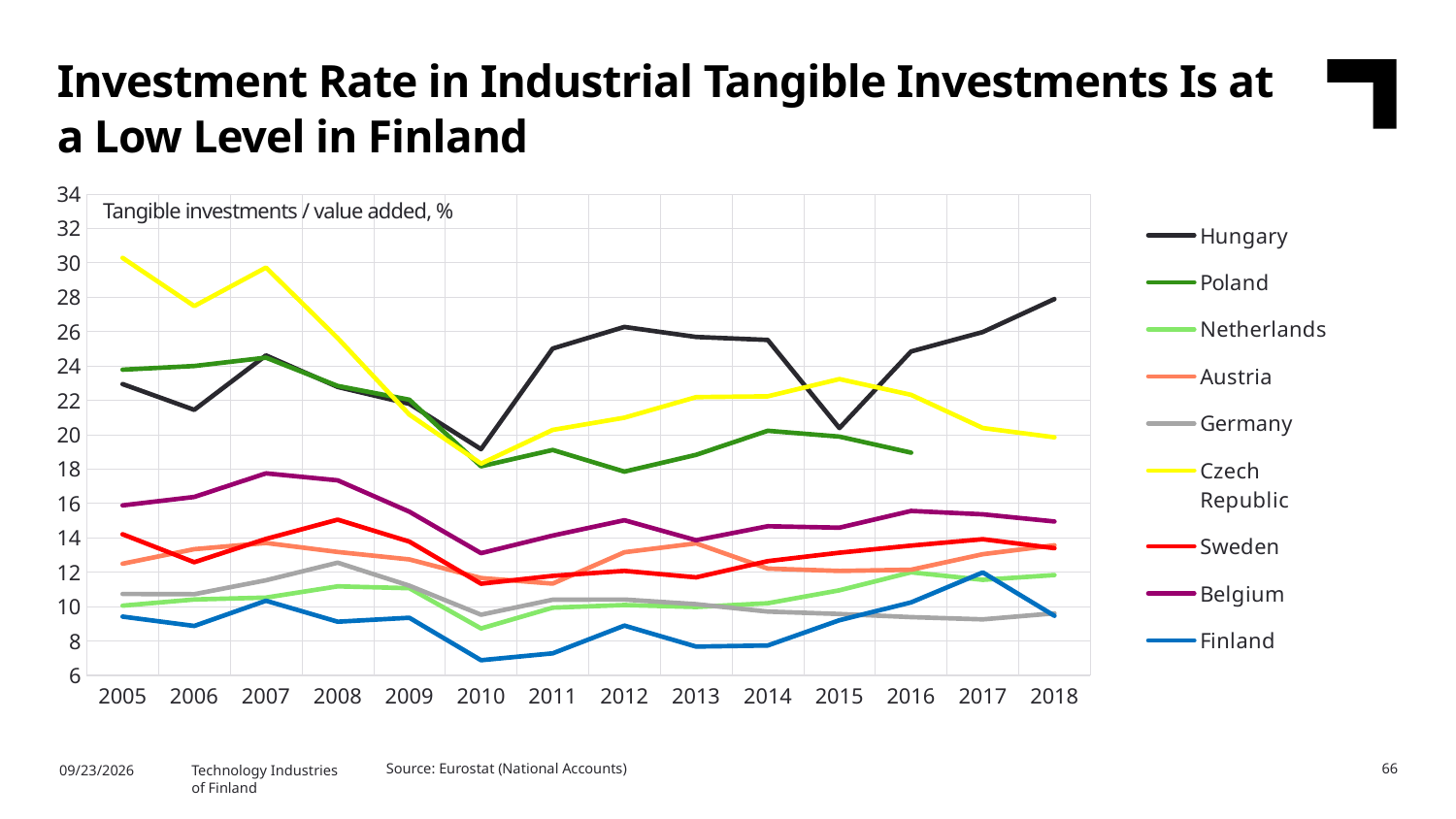
Which country has the lowest value in 2010? Finland How many series does the legend list? 9 Is the value for Hungary in 2018 greater or less than 26? greater How many years are shown on the x axis? 14 Which country has the highest value in 2005? Czech Republic Which country has the highest value in 2018? Hungary Which is larger in 2010, the value for Germany or the value for Finland? Germany Is the value for Belgium in 2007 greater or less than 16? greater What kind of chart is shown on the slide? Line chart Is the value for Finland in 2010 greater or less than 8? less Does the value for the Czech Republic rise or fall from 2005 to 2010? Fall What label is printed inside the plot area at the top left of the chart? Tangible investments / value added, %